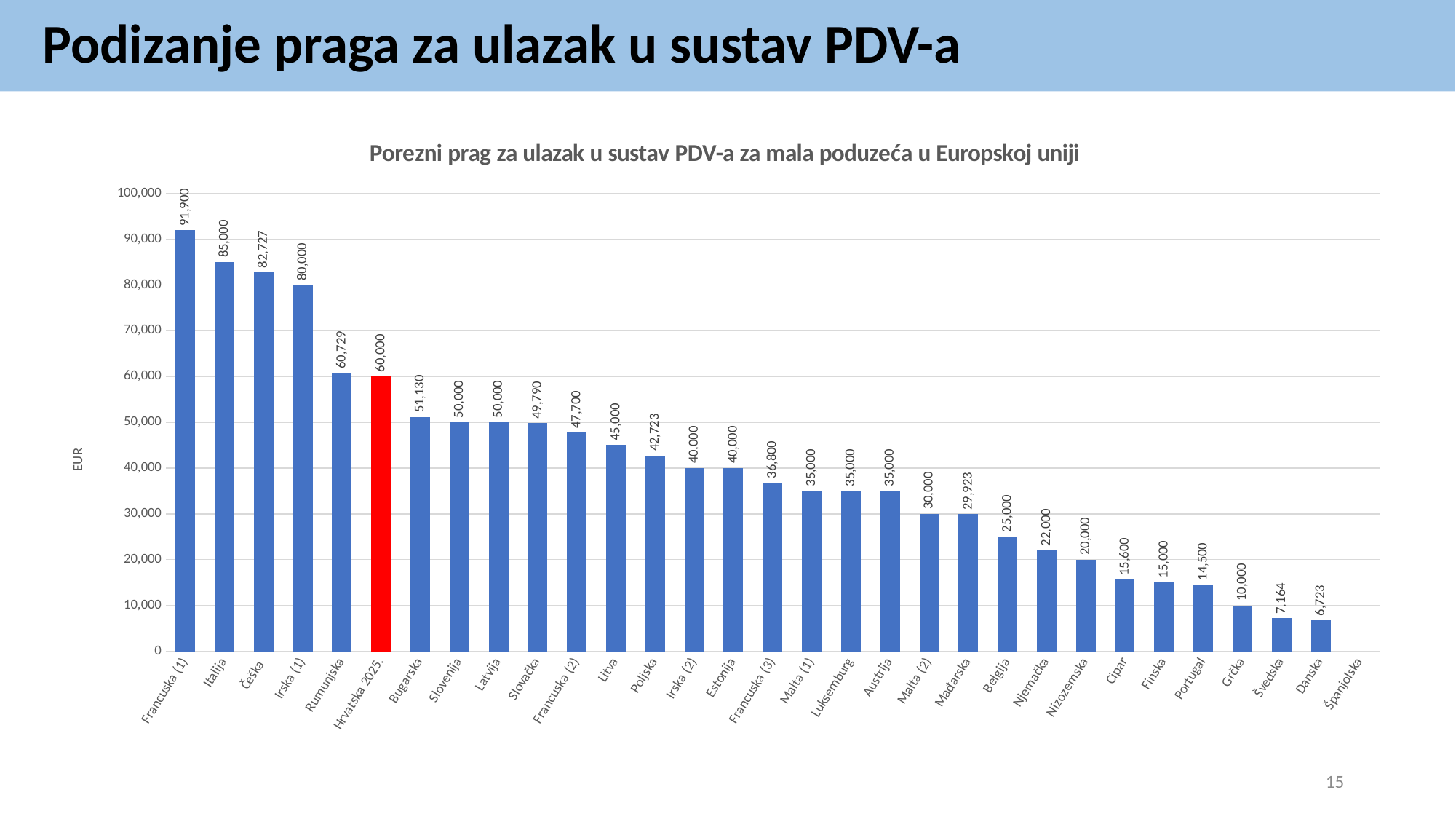
What kind of chart is shown on the slide? bar chart What is the value for Hrvatska 2025.? 60,000 What is the value for Bugarska? 51,130 What is the value for Češka? 82,727 What unit is shown on the vertical axis label? EUR What is the difference between the values for Rumunjska and Hrvatska 2025.? 729 What is the difference between the values for Francuska (1) and Italija? 6,900 Which is larger, the value for Poljska or the value for Litva? Litva Which country's bar is coloured red? Hrvatska 2025. What is the value for Mađarska? 29,923 Which country has the lowest printed value? Danska Which country has the highest value? Francuska (1)